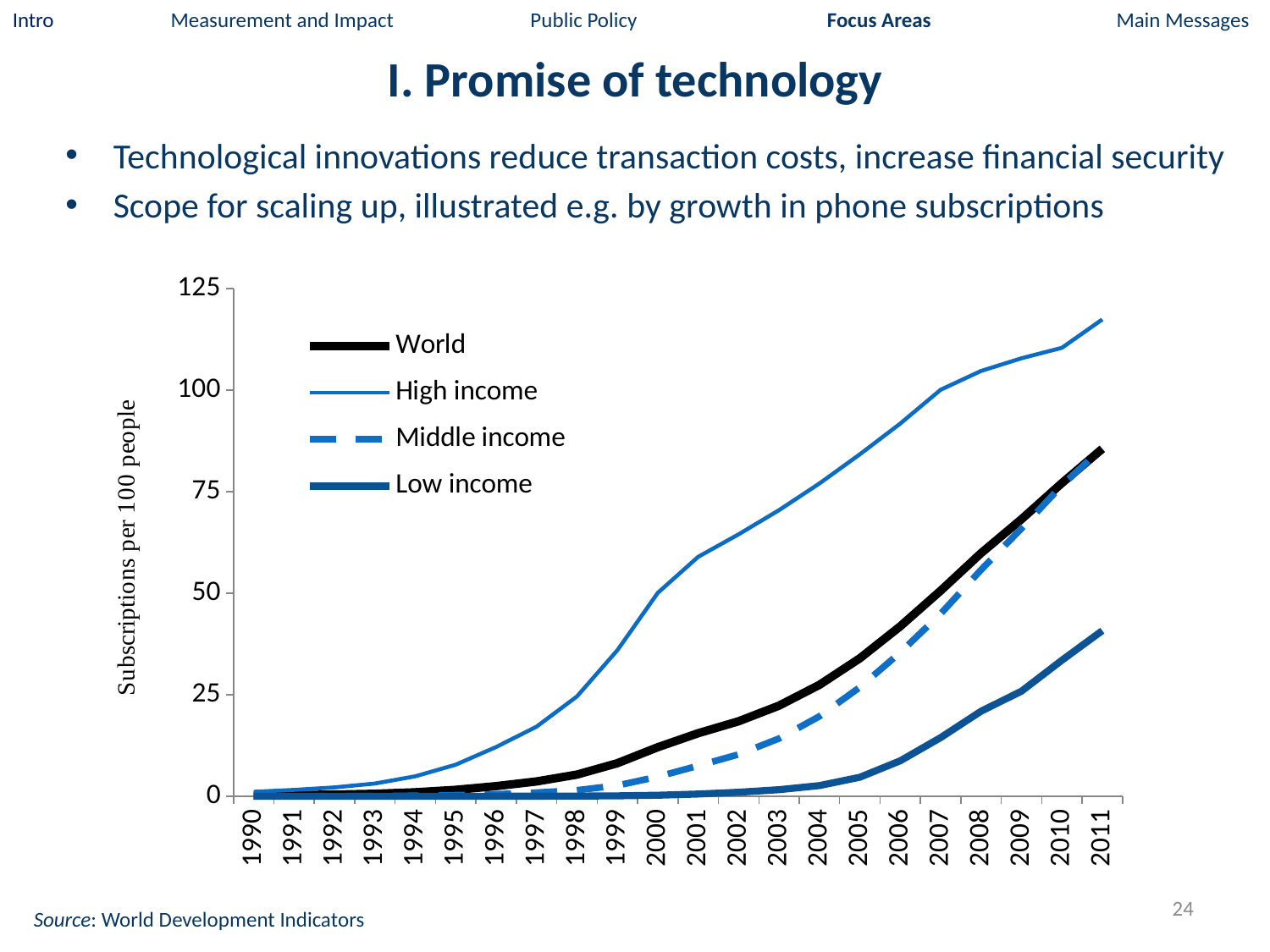
Which series has the highest value in 2011? High income How many series does the legend list? 4 Is the value for World in 2011 greater or less than 75? greater What is the label on the y axis? Subscriptions per 100 people Is the value for Low income in 2011 greater or less than 50? less How many years are shown along the x axis? 22 What kind of chart is shown on the slide? line chart Which series has the lowest value in 2011? Low income Do the High income values rise or fall from 1990 to 2011? rise Is the value for Low income in 2005 greater or less than 25? less In 2008, which is larger: Middle income or Low income? Middle income